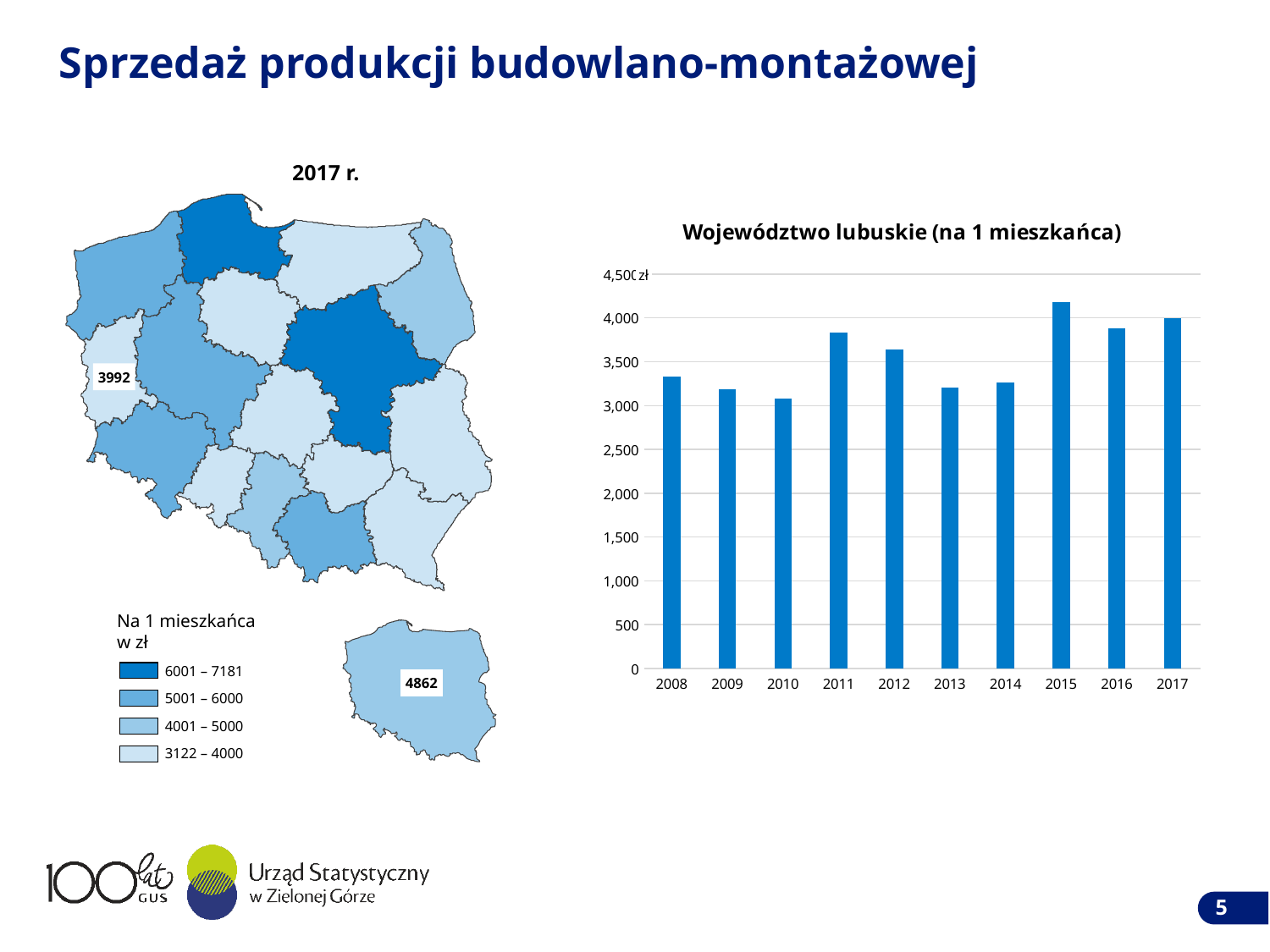
In the chart 'Województwo lubuskie (na 1 mieszkańca)', is the value for 2015 greater or less than 4,000? greater In the chart 'Województwo lubuskie (na 1 mieszkańca)', do the values rise or fall from 2008 to 2010? fall What kind of chart is 'Województwo lubuskie (na 1 mieszkańca)'? bar chart In the chart 'Województwo lubuskie (na 1 mieszkańca)', which year has the larger value, 2011 or 2012? 2011 In the chart 'Województwo lubuskie (na 1 mieszkańca)', is the value for 2008 greater or less than 3,500? less In the chart 'Województwo lubuskie (na 1 mieszkańca)', is the value for 2011 greater or less than 3,500? greater In the chart 'Województwo lubuskie (na 1 mieszkańca)', how many years are shown on the x axis? 10 In the chart 'Województwo lubuskie (na 1 mieszkańca)', which year has the highest value? 2015 In the chart 'Województwo lubuskie (na 1 mieszkańca)', which year has the lowest value? 2010 What is the title of the bar chart on the right of the slide? Województwo lubuskie (na 1 mieszkańca) In the chart 'Województwo lubuskie (na 1 mieszkańca)', which year has the larger value, 2008 or 2015? 2015